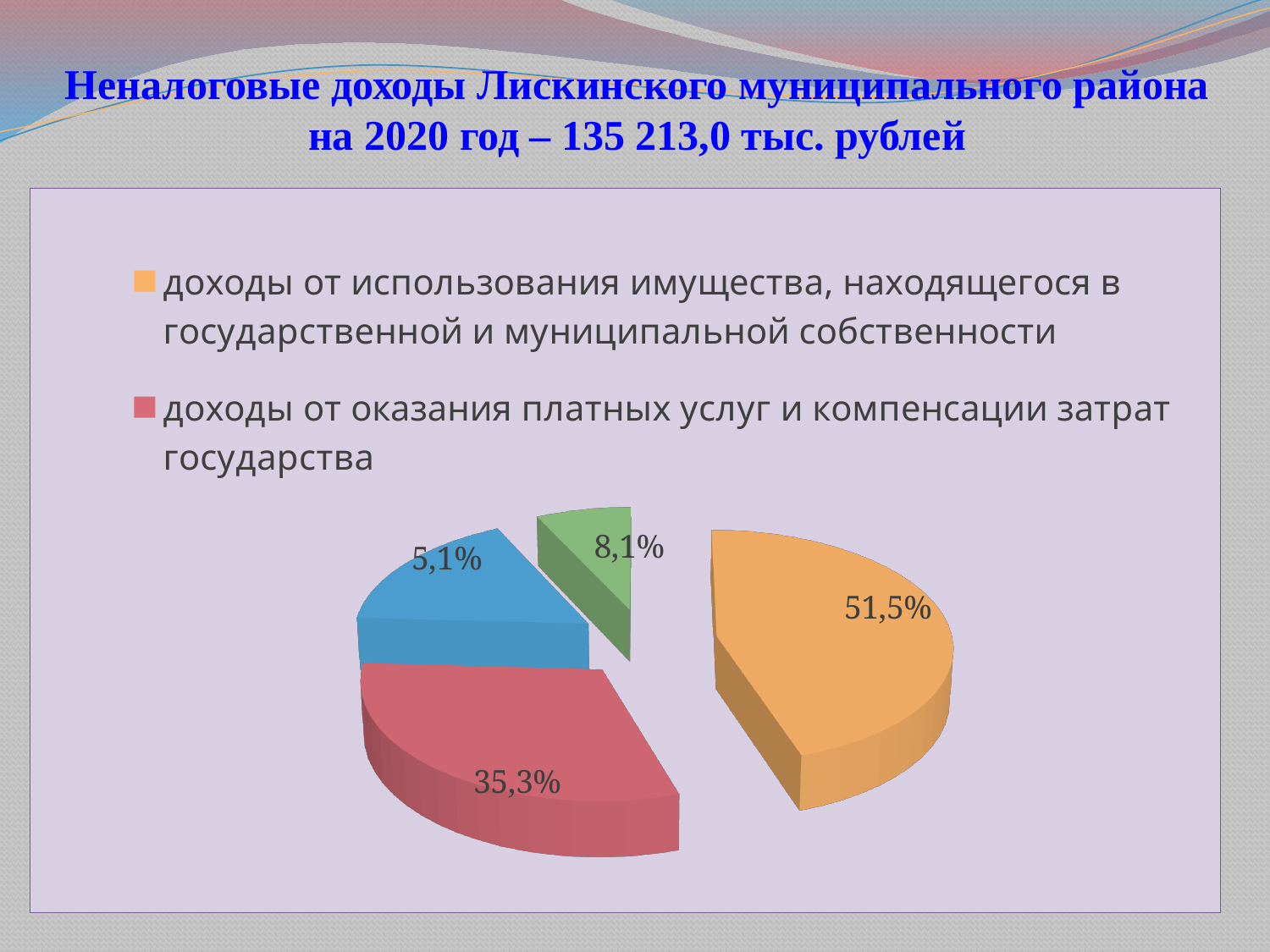
What kind of chart is shown on the slide? pie chart How many slices does the pie chart have? 4 What is the difference in percentage points between the slice for доходы от использования имущества and the slice for доходы от оказания платных услуг? 16,2 What share of the pie is labelled for доходы от оказания платных услуг и компенсации затрат государства? 35,3% What colour is the slice for доходы от оказания платных услуг и компенсации затрат государства? red Which category has the largest slice of the pie? доходы от использования имущества, находящегося в государственной и муниципальной собственности What percentage is printed on the green slice of the pie? 8,1% What percentage is printed on the blue slice of the pie? 5,1% What share of the pie is labelled for доходы от использования имущества, находящегося в государственной и муниципальной собственности? 51,5% How many entries does the legend list? 2